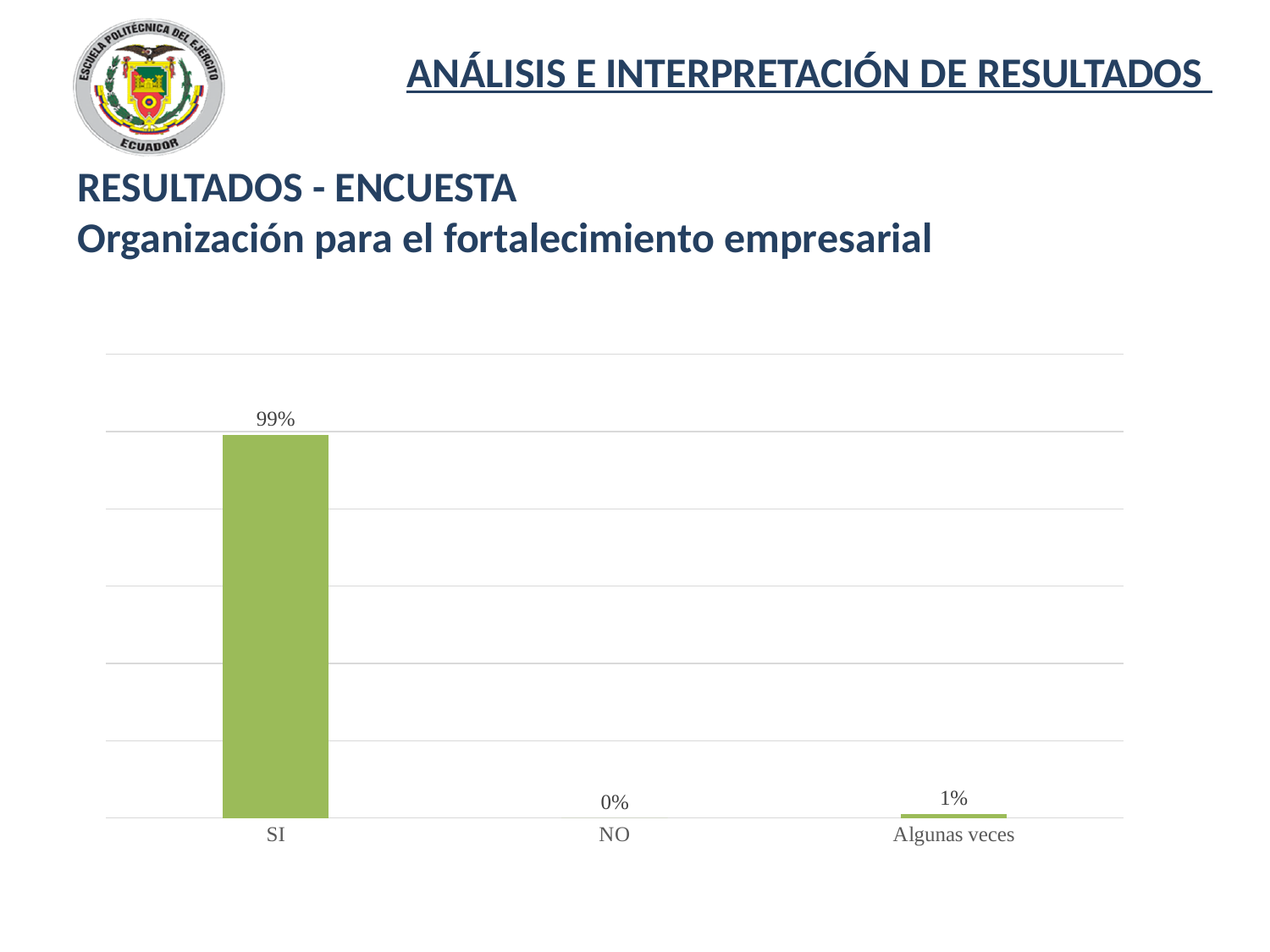
What is the value for Algunas veces? 1% What kind of chart is shown on the slide? bar chart What is the value for NO? 0% How many categories are shown on the x axis? 3 What is the label of the third category on the x axis? Algunas veces What is the total of the three values shown? 100% What is the value for SI? 99% Which category has the highest value? SI What colour are the bars in the chart? green What is the difference between the values for SI and Algunas veces? 98% Which is larger, the value for Algunas veces or the value for NO? Algunas veces Which category has the lowest value? NO